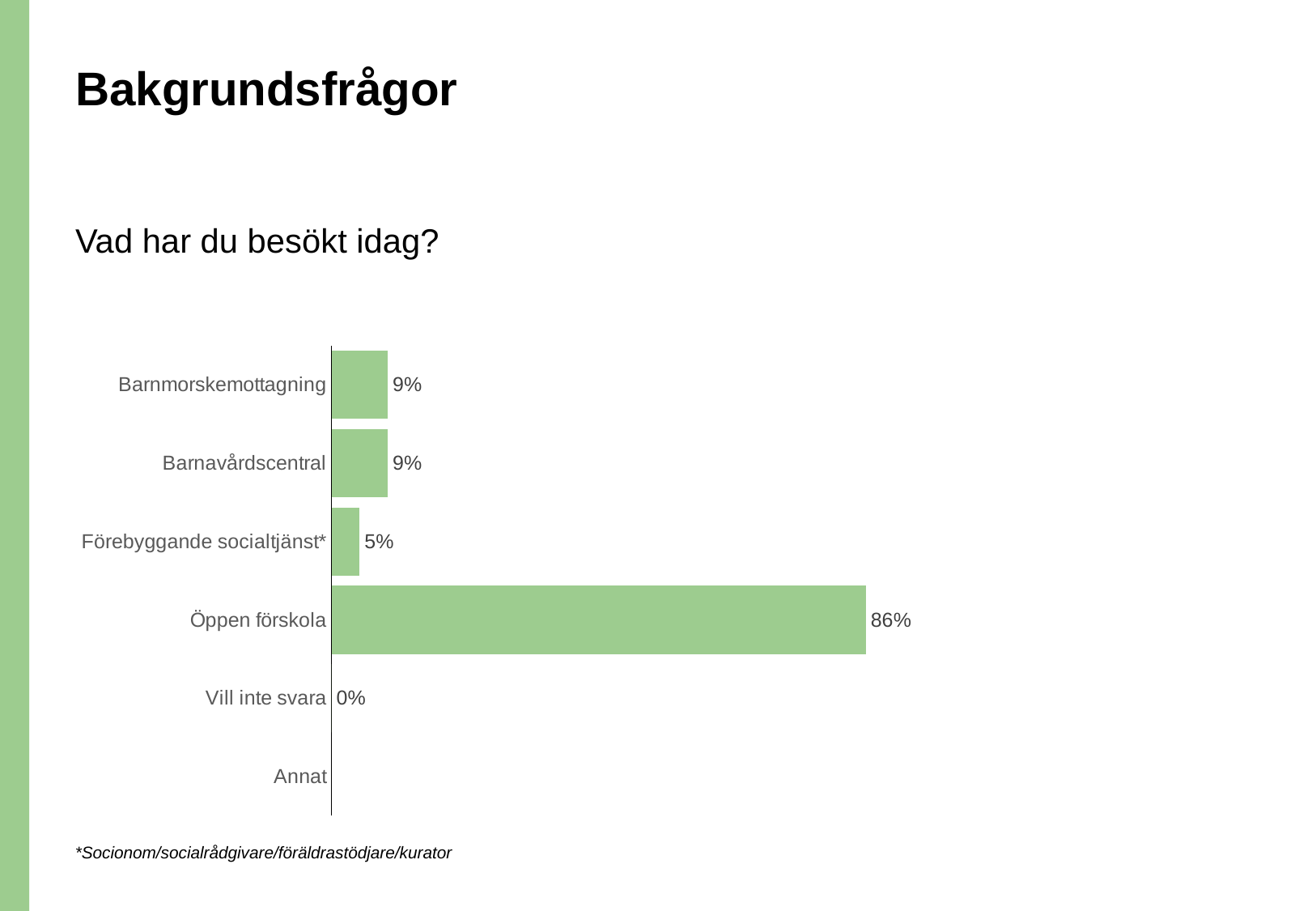
What kind of chart is shown on the slide? Bar chart What is the value for Vill inte svara? 0% What question does the chart answer, as written above it? Vad har du besökt idag? Which category has the highest value? Öppen förskola What is the difference between the values for Barnmorskemottagning and Förebyggande socialtjänst*? 4% How many categories are shown on the chart? 6 What is the value for Barnmorskemottagning? 9% What colour are the bars in the chart? Green Which is larger, the value for Barnavårdscentral or the value for Förebyggande socialtjänst*? Barnavårdscentral What is the value for Förebyggande socialtjänst*? 5% What is the difference between the values for Öppen förskola and Barnavårdscentral? 77% What is the value for Öppen förskola? 86%